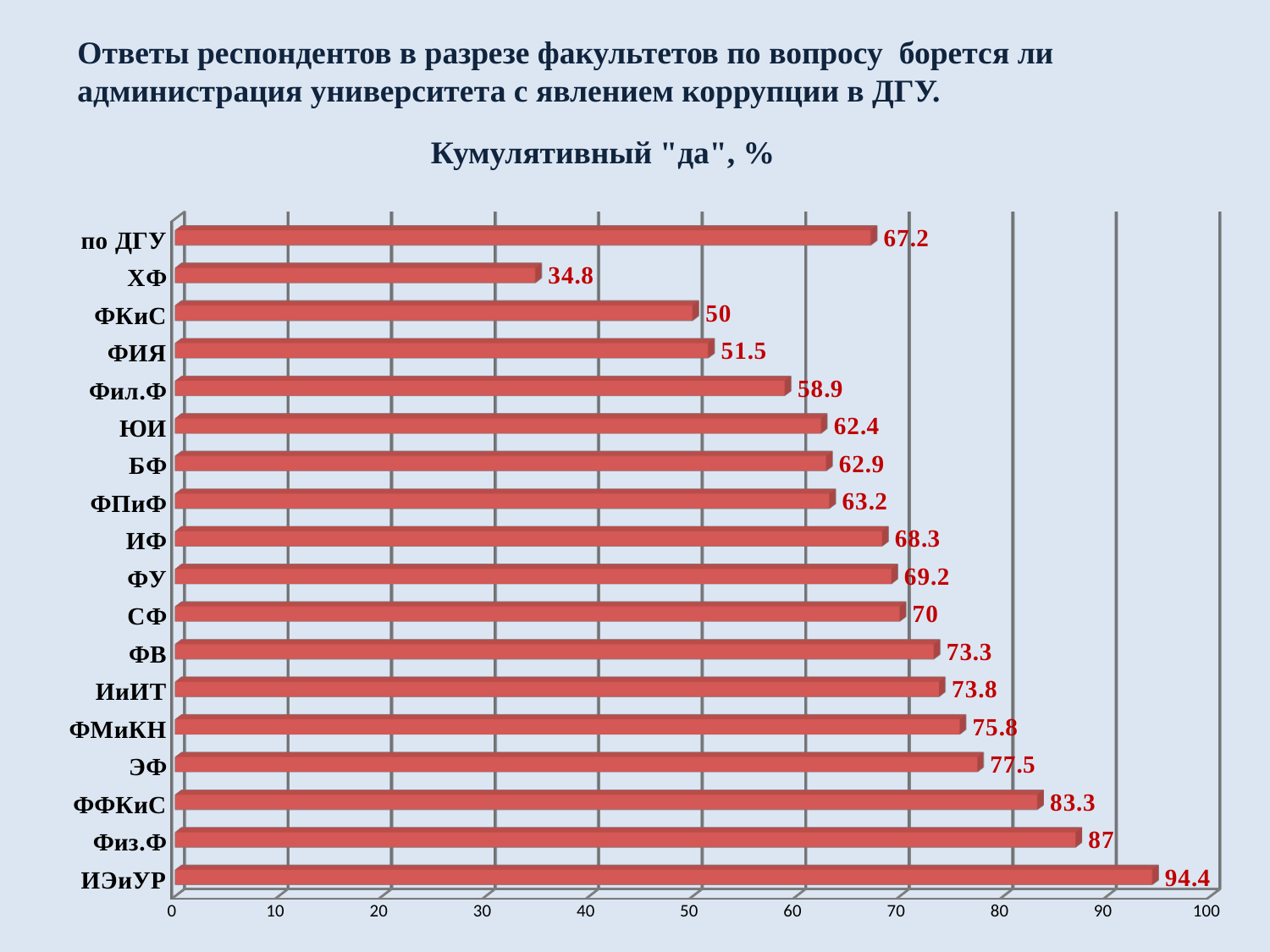
Which category has the highest value? ИЭиУР Which category has the lowest value? ХФ What is the difference between the values for ФФКиС and ЭФ? 5.8 Is the value for Физ.Ф greater or less than 80? greater What is the value for ИЭиУР? 94.4 Which is larger, the value for ЭФ or the value for ФВ? ЭФ What kind of chart is shown on the slide? bar chart What is the value for по ДГУ? 67.2 What is the difference between the values for ИЭиУР and ХФ? 59.6 What is the value for ХФ? 34.8 What is the title of the chart? Кумулятивный "да", % How many categories are shown on the chart? 18